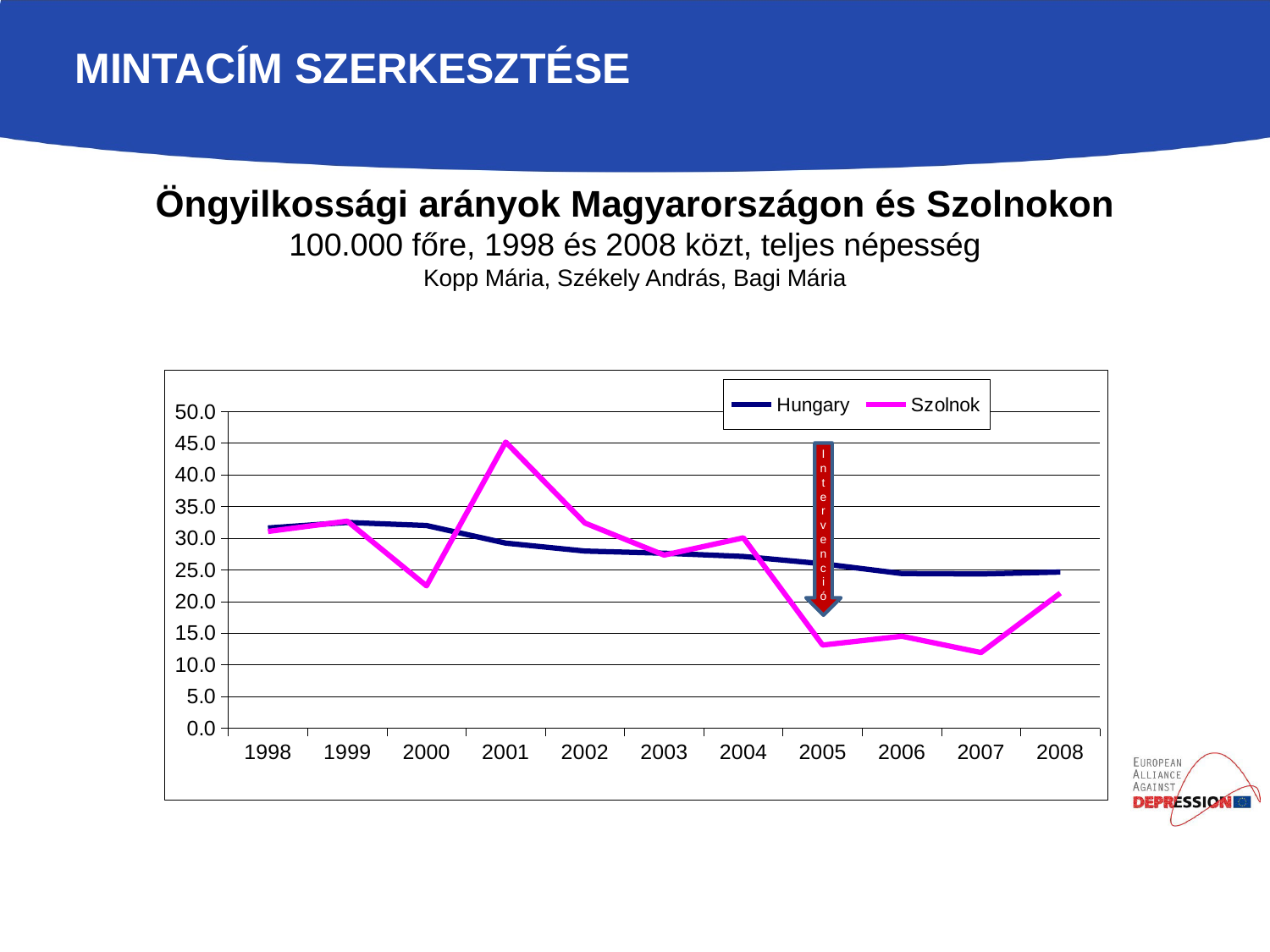
How many years are shown on the x axis of the chart? 11 Is the value for Szolnok in 2000 greater or less than 25.0? less Which series has the larger value in 2001, Hungary or Szolnok? Szolnok Is the value for Hungary in 1998 greater or less than 30.0? greater In which year does the Szolnok series reach its highest value? 2001 What kind of chart is shown on the slide? line chart Does the Hungary series generally rise or fall from 1998 to 2008? fall What colour is the Szolnok line in the chart? magenta How many series does the chart legend list? 2 In which year does the Szolnok series reach its lowest value? 2007 Which series has the larger value in 2005, Hungary or Szolnok? Hungary Is the value for Szolnok in 2007 greater or less than 15.0? less